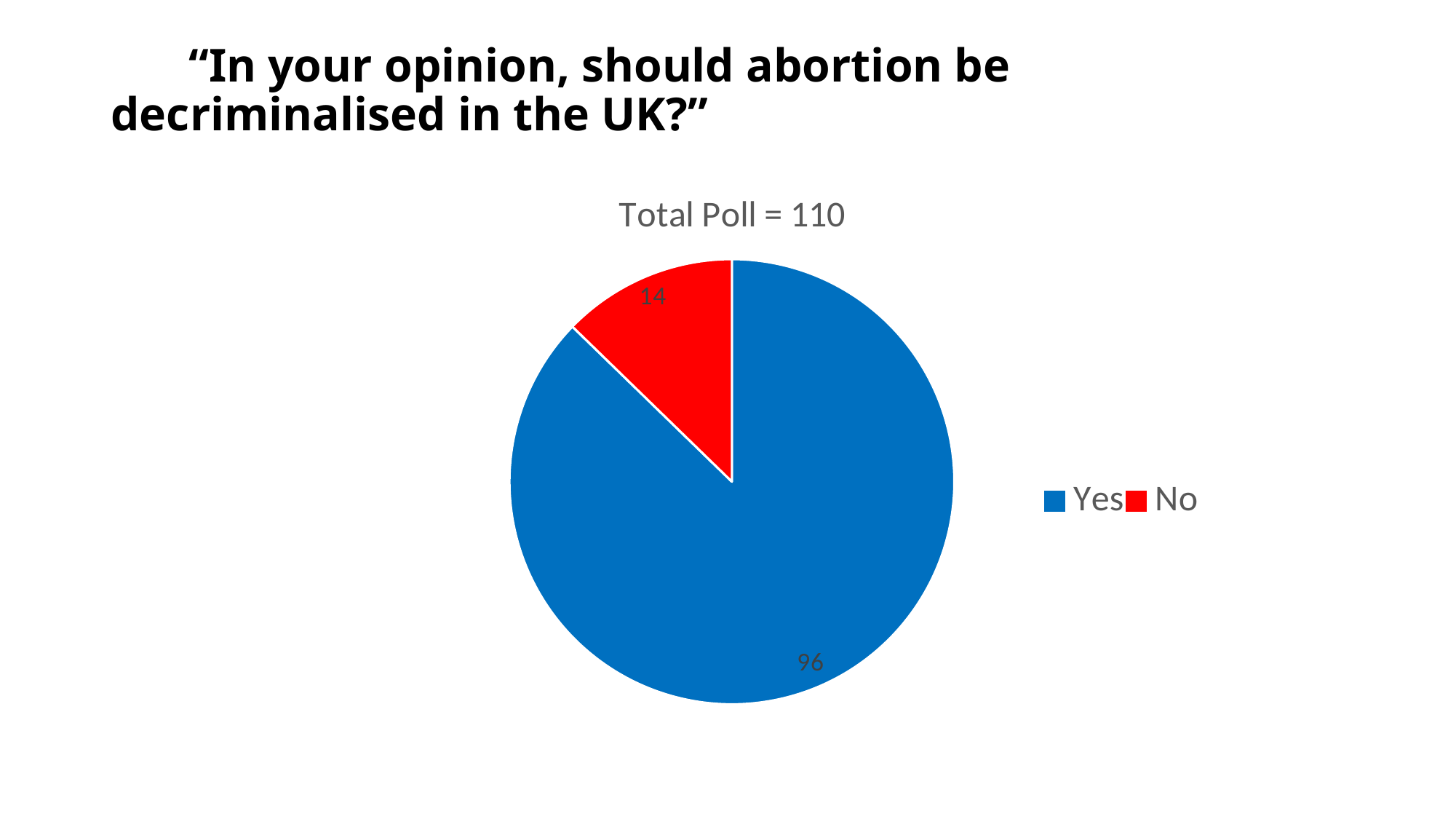
What colour is the No slice? red How many people answered Yes? 96 How many entries does the legend list? 2 What type of chart is shown on the slide? pie chart How many people answered No? 14 What is the total of the two slices? 110 Which response has the smallest slice of the pie? No Which response has the largest slice of the pie? Yes Which is larger, the Yes count or the No count? Yes What is the chart's title? Total Poll = 110 What is the difference between the number of Yes and No responses? 82 How many slices does the pie chart have? 2